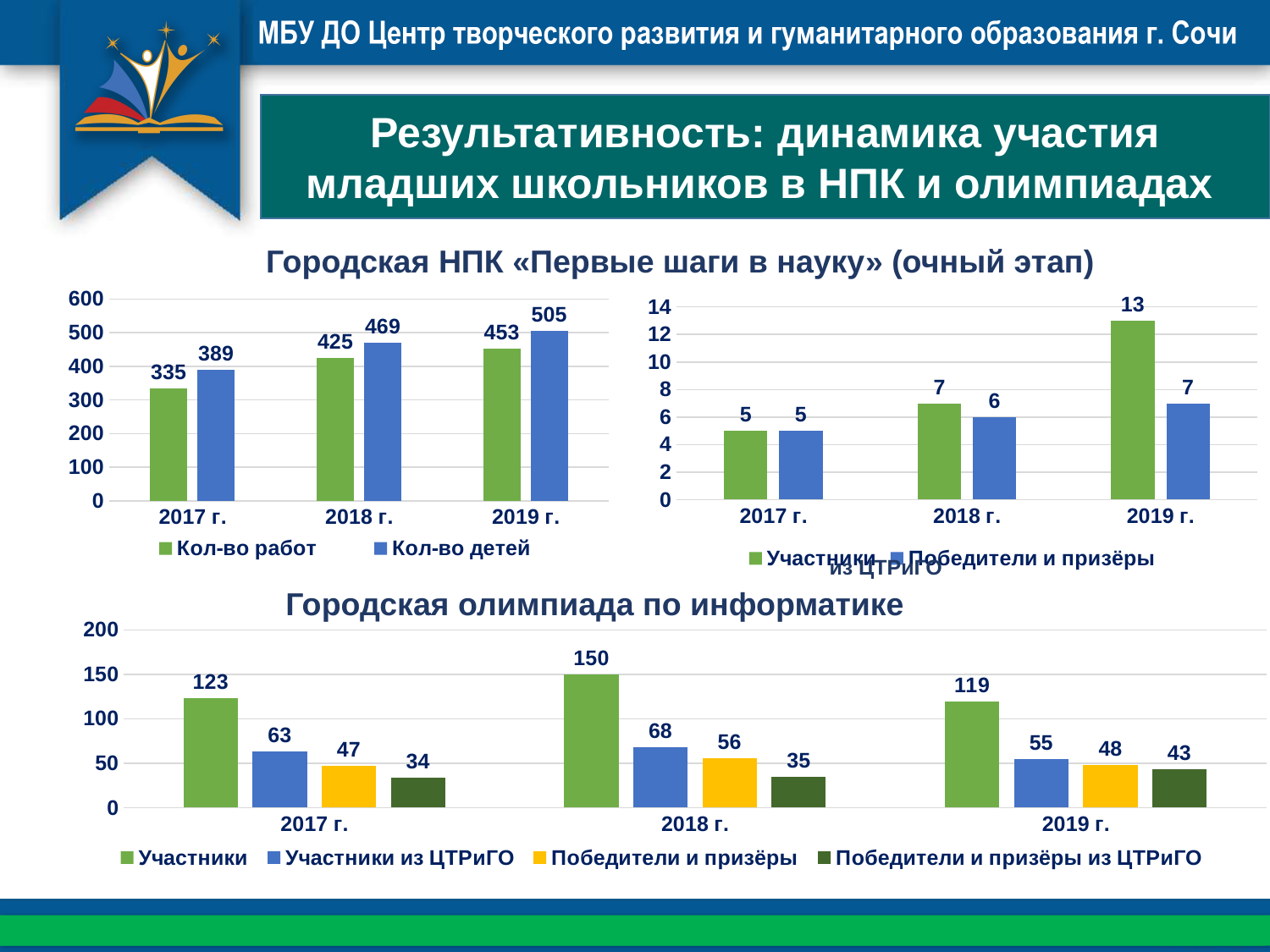
In the chart «Городская олимпиада по информатике», how many series does the legend list? 4 In the chart «Городская олимпиада по информатике», which is larger: «Победители и призёры» in 2018 г. or «Победители и призёры» in 2019 г.? 2018 г. In the top-right chart, what is the value of «Участники из ЦТРиГО» for 2019 г.? 13 In the top-left chart, what is the difference between «Кол-во детей» and «Кол-во работ» in 2019 г.? 52 In the top-left chart, what is the value of «Кол-во работ» for 2017 г.? 335 In the chart «Городская олимпиада по информатике», which year has the lowest value of «Участники»? 2019 г. In the top-right chart, which year has the highest value of «Победители и призёры»? 2019 г. In the top-left chart, what is the value of «Кол-во детей» for 2018 г.? 469 In the top-left chart, do the values of «Кол-во работ» rise or fall from 2017 г. to 2019 г.? rise In the top-right chart, how many years are shown on the x axis? 3 What type of chart is «Городская олимпиада по информатике»? bar chart In the chart «Городская олимпиада по информатике», what is the value of «Участники» for 2018 г.? 150